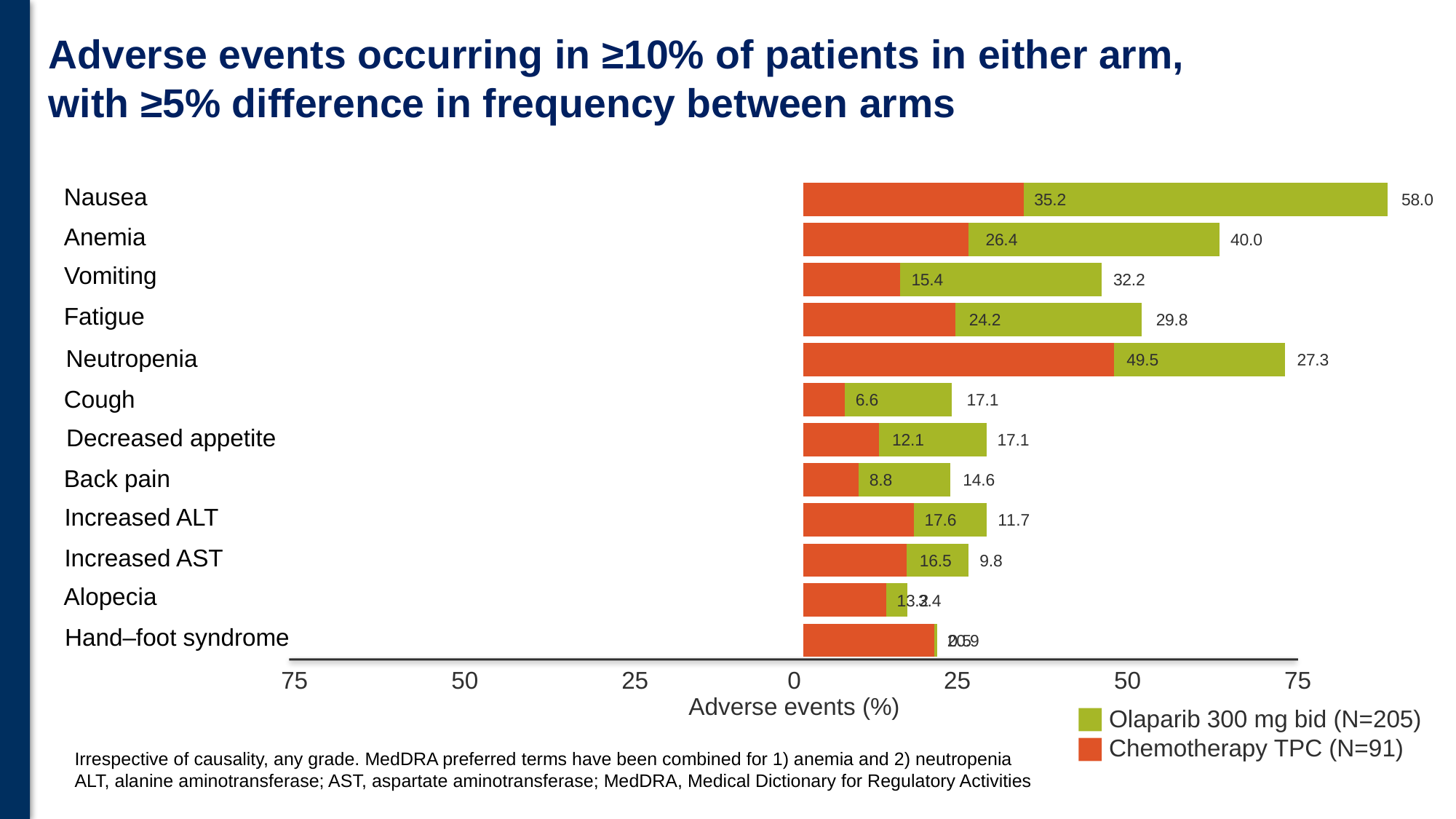
What is the Olaparib 300 mg bid value for Vomiting? 32.2 How many series does the legend list? 2 Which adverse event has the highest Chemotherapy TPC value? Neutropenia What is the Chemotherapy TPC value for Neutropenia? 49.5 Which adverse event has the highest Olaparib 300 mg bid value? Nausea What is the difference between the Olaparib and Chemotherapy TPC values for Anemia? 13.6 What kind of chart is shown on the slide? Bar chart How many adverse events are listed on the chart? 12 Which colour represents Chemotherapy TPC (N=91) in the legend? Red/orange What is the Olaparib 300 mg bid value for Nausea? 58.0 What is the Chemotherapy TPC value for Cough? 6.6 For Increased ALT, which arm has the larger value, Olaparib 300 mg bid or Chemotherapy TPC? Chemotherapy TPC